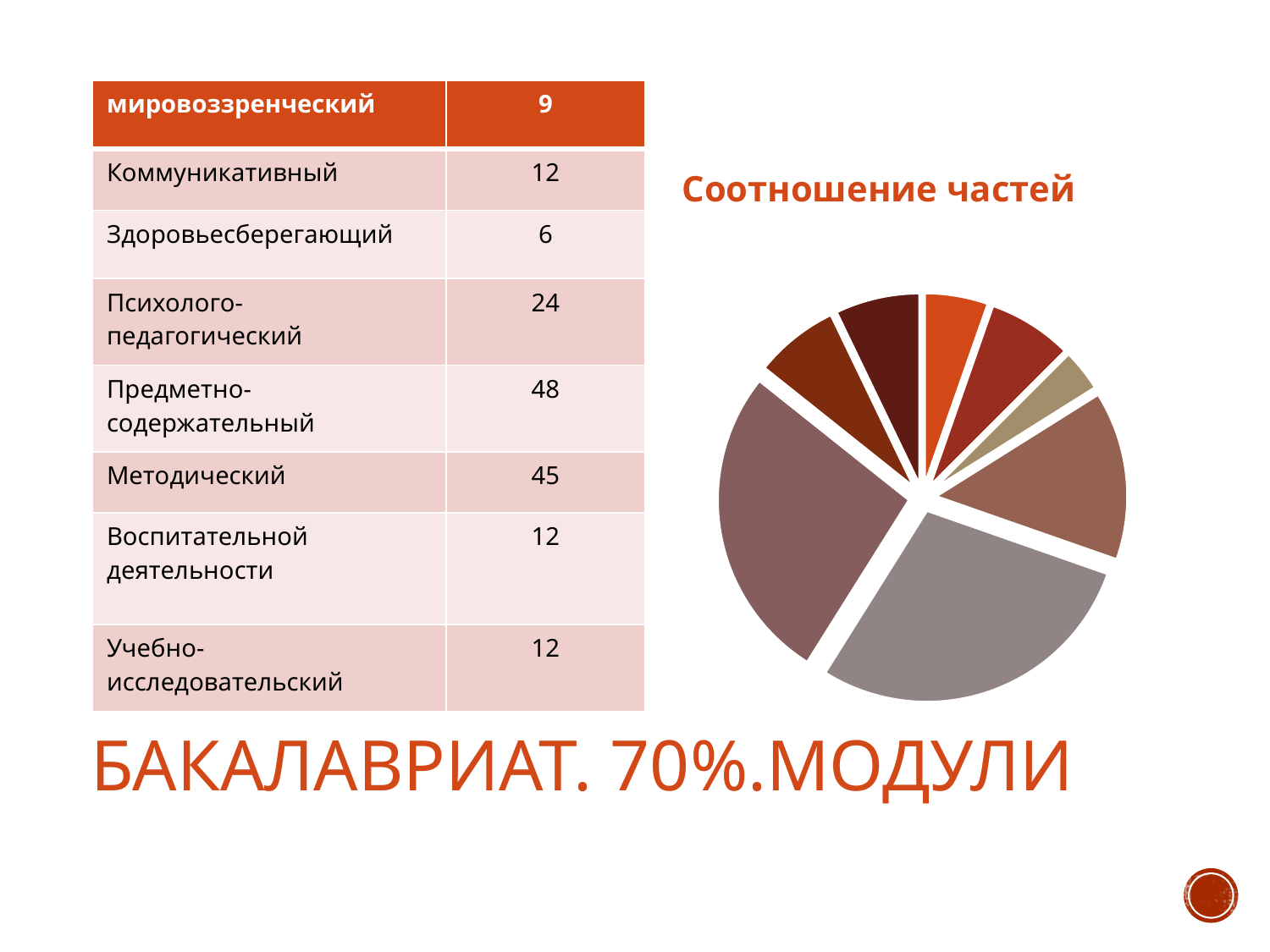
Which category in the table accompanying the pie chart has the smallest value? Здоровьесберегающий Which has the larger value in the table accompanying the pie chart, Коммуникативный or Здоровьесберегающий? Коммуникативный According to the table accompanying the pie chart, what is the value for Методический? 45 What kind of chart is shown under the title "Соотношение частей"? pie chart According to the table accompanying the pie chart, what is the value for Здоровьесберегающий? 6 What is the title of the chart on the slide? Соотношение частей According to the table accompanying the pie chart, what is the value for Психолого-педагогический? 24 Which has the larger value in the table accompanying the pie chart, Психолого-педагогический or мировоззренческий? Психолого-педагогический According to the table accompanying the pie chart, what is the value for Предметно-содержательный? 48 How many slices does the pie chart "Соотношение частей" have? 8 Does the pie chart "Соотношение частей" display a legend? No What is the difference between the values for Предметно-содержательный and Методический in the table accompanying the pie chart? 3